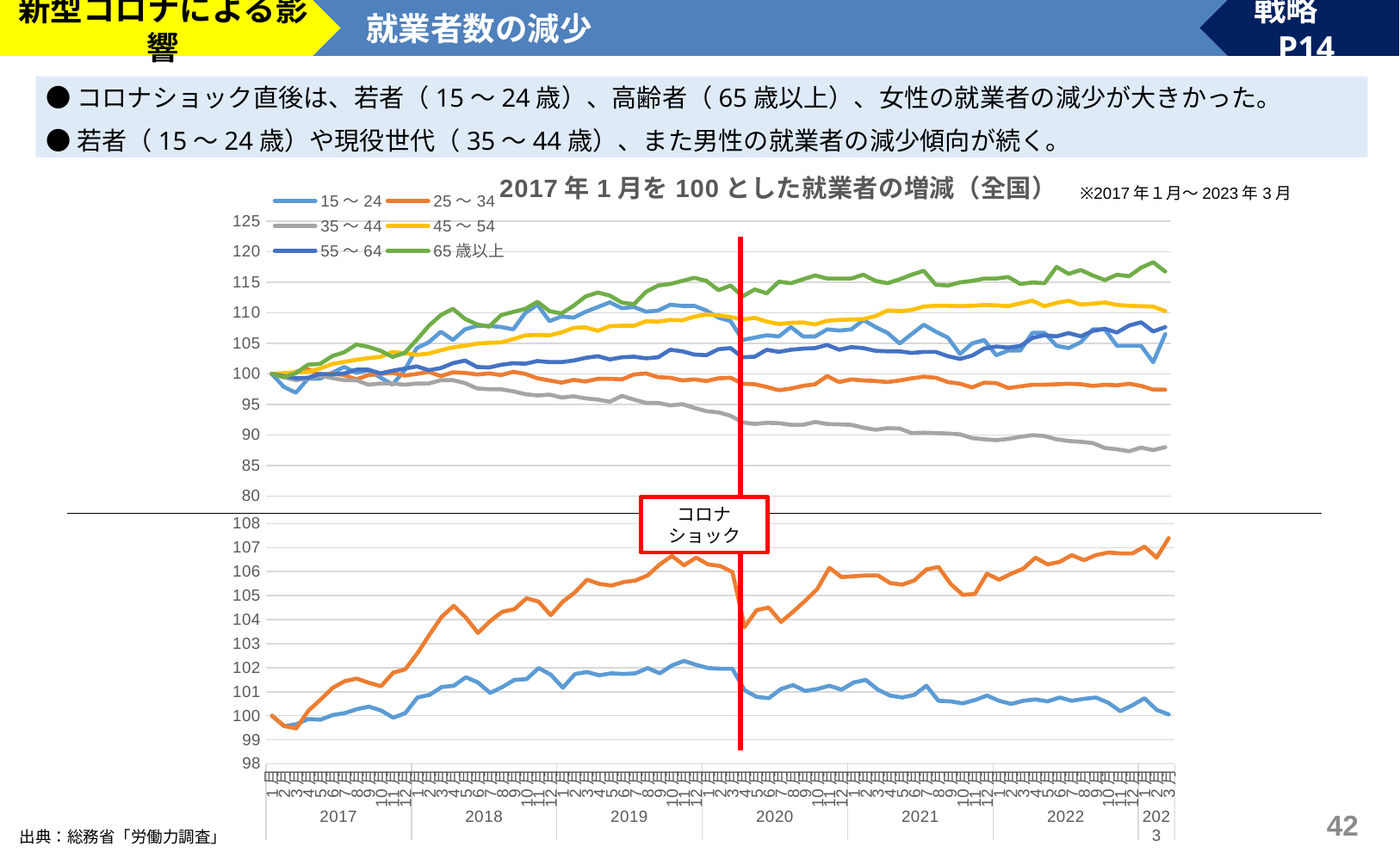
What is the title of the top chart? 2017年1月を100とした就業者の増減（全国） In the top chart, is the value for 65歳以上 at the end of the period greater or less than 115? greater In the top chart, which age group series is highest at the end of the period (2023年3月)? 65歳以上 In the top chart, is the value for 25～34 at the end of the period greater or less than 100? less In the top chart, is the value for 35～44 at the end of the period greater or less than 90? less How many series does the legend of the top chart list? 6 In the top chart, which age group series is lowest at the end of the period (2023年3月)? 35～44 What event does the red vertical line on the charts mark? コロナショック In the bottom chart, which line is higher at the end of the period, the orange line or the blue line? orange line In the top chart, does the 35～44 series rise or fall over the period from 2017 to 2023? fall What kind of chart is the top chart on the slide? line chart